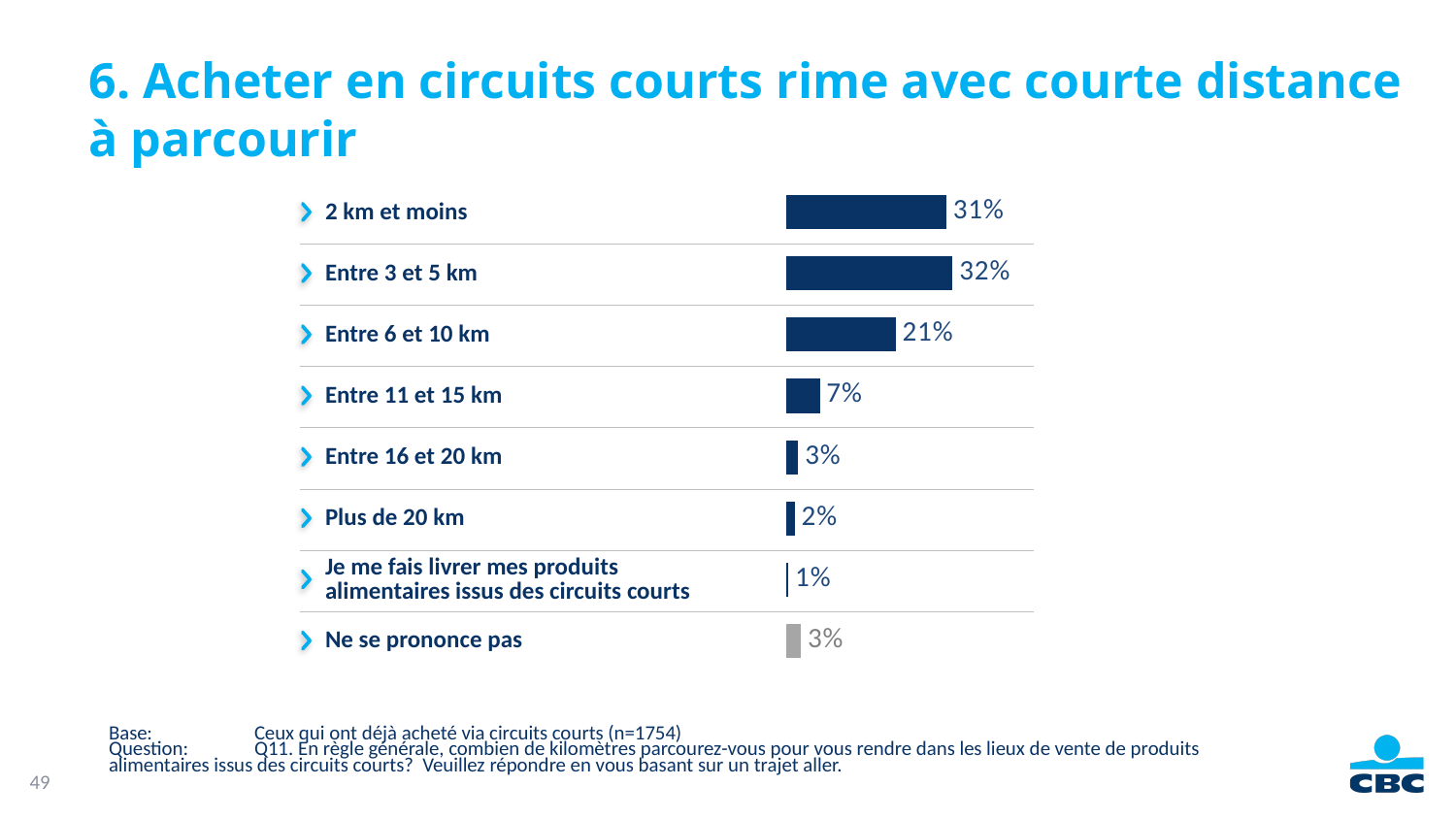
Which category has the lowest value? Je me fais livrer mes produits alimentaires issus des circuits courts What is the difference between the values for "Entre 3 et 5 km" and "Entre 6 et 10 km"? 11% What is the value for "Entre 6 et 10 km"? 21% Which bar is shown in grey rather than dark blue? Ne se prononce pas What is the value for "Je me fais livrer mes produits alimentaires issus des circuits courts"? 1% What is the value for "Entre 11 et 15 km"? 7% How many categories are shown in the chart? 8 Which category has the highest value? Entre 3 et 5 km What is the value for "Ne se prononce pas"? 3% What kind of chart is shown on the slide? Bar chart What is the value for "2 km et moins"? 31% Which is larger, the value for "Entre 11 et 15 km" or the value for "Entre 16 et 20 km"? Entre 11 et 15 km